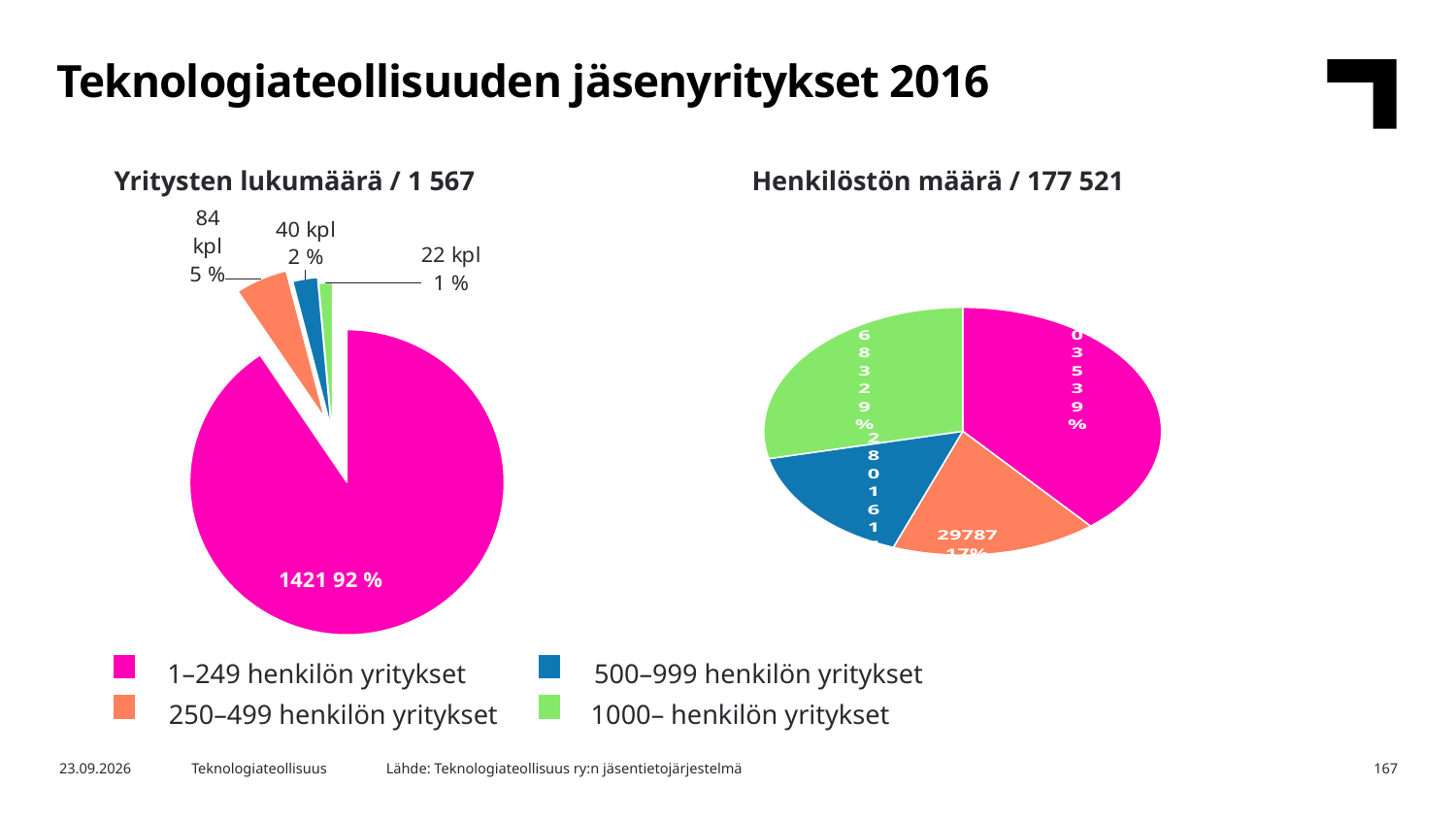
In the left chart 'Yritysten lukumäärä / 1 567', what is the value for 1000– henkilön yritykset? 22 kpl How many categories does the shared legend list for the pie charts? 4 In the left chart 'Yritysten lukumäärä / 1 567', which category has the smallest slice? 1000– henkilön yritykset In the left chart 'Yritysten lukumäärä / 1 567', which category has the largest slice? 1–249 henkilön yritykset What kind of chart is the left chart titled 'Yritysten lukumäärä / 1 567'? Pie chart In the right chart 'Henkilöstön määrä / 177 521', what is the value for 250–499 henkilön yritykset? 29787 In the left chart 'Yritysten lukumäärä / 1 567', what is the value for 500–999 henkilön yritykset? 40 kpl In the left chart 'Yritysten lukumäärä / 1 567', how many more companies are in the 250–499 category than in the 500–999 category? 44 In the right chart 'Henkilöstön määrä / 177 521', which category has the largest slice? 1–249 henkilön yritykset In the left chart 'Yritysten lukumäärä / 1 567', what share of the pie do 1–249 henkilön yritykset make up? 92 % In the left chart 'Yritysten lukumäärä / 1 567', how many companies are in the 1–249 henkilön yritykset category? 1421 In the left chart 'Yritysten lukumäärä / 1 567', what is the value for 250–499 henkilön yritykset? 84 kpl